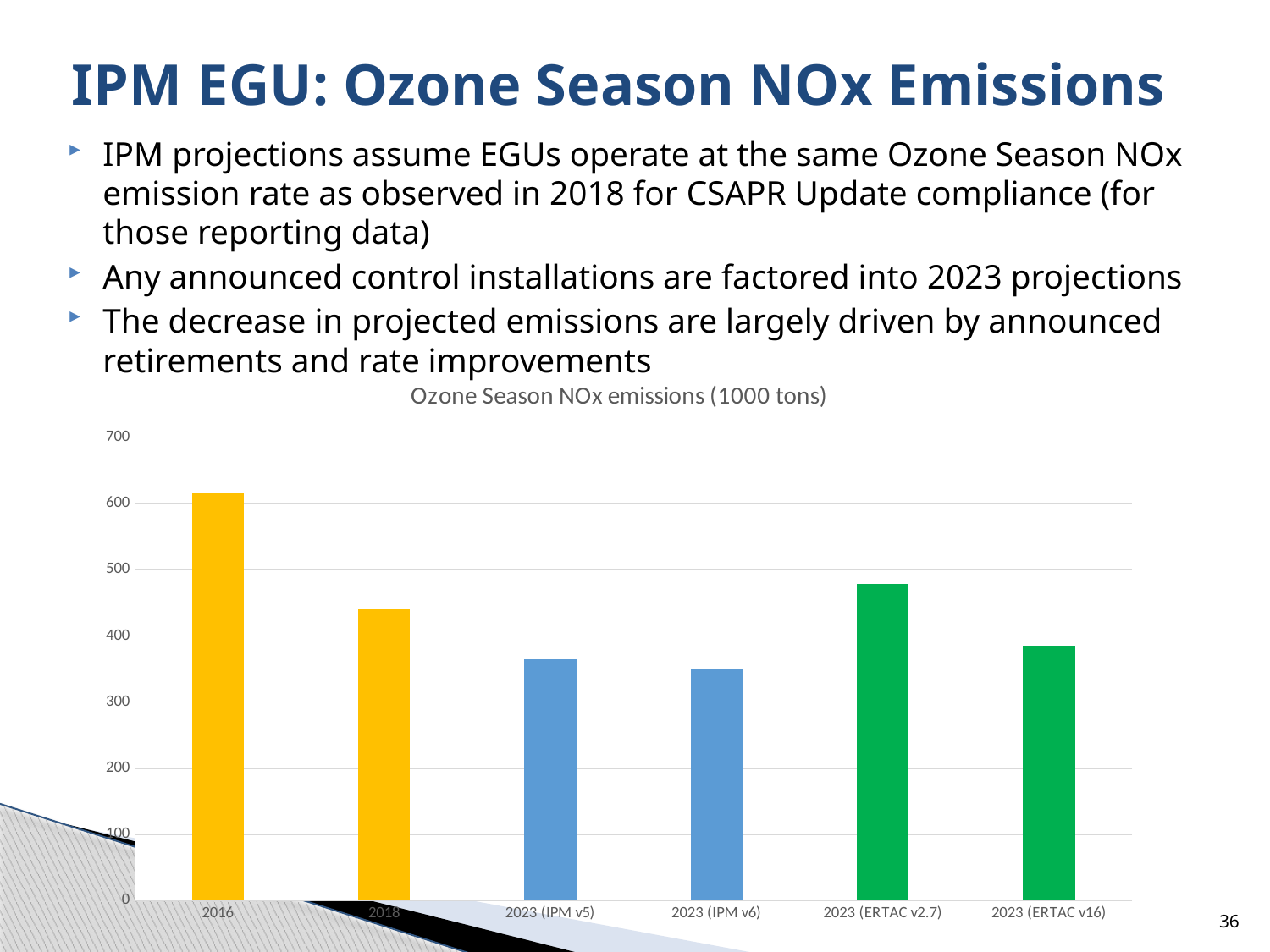
Which category has the highest Ozone Season NOx emissions? 2016 Is the value for 2023 (IPM v5) greater or less than 400? less What kind of chart is shown on the slide? Bar chart Is the value for 2023 (ERTAC v16) greater or less than 400? less How many bars (categories) are plotted in the chart? 6 Is the value for 2023 (ERTAC v2.7) greater or less than 500? less What is the title of the chart? Ozone Season NOx emissions (1000 tons) Which is larger, the value for 2016 or the value for 2018? 2016 Which is larger, the value for 2023 (ERTAC v2.7) or the value for 2023 (ERTAC v16)? 2023 (ERTAC v2.7) Which is larger, the value for 2018 or the value for 2023 (IPM v6)? 2018